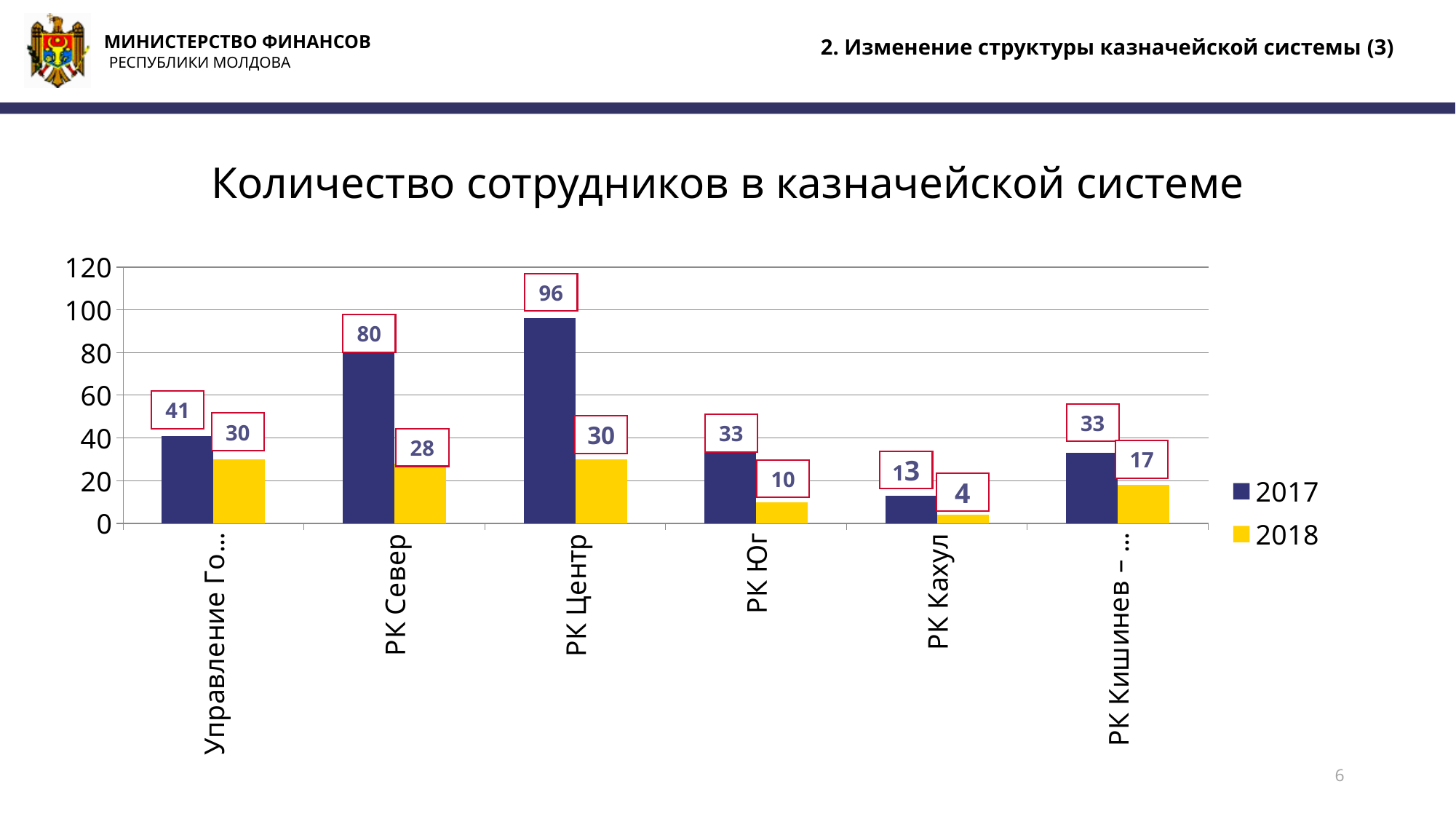
What is the 2017 value for РК Север? 80 What is the title of the chart? Количество сотрудников в казначейской системе Which is larger for РК Кахул, the 2017 value or the 2018 value? 2017 Which category has the lowest 2018 value? РК Кахул What is the 2018 value for РК Центр? 30 Which category has the highest 2017 value? РК Центр What is the 2018 value for РК Юг? 10 Which colour represents the 2018 series in the legend? yellow How many categories are shown on the x axis? 6 How many series does the legend list? 2 What kind of chart is shown on the slide? bar chart What is the difference between the 2017 and 2018 values for РК Север? 52